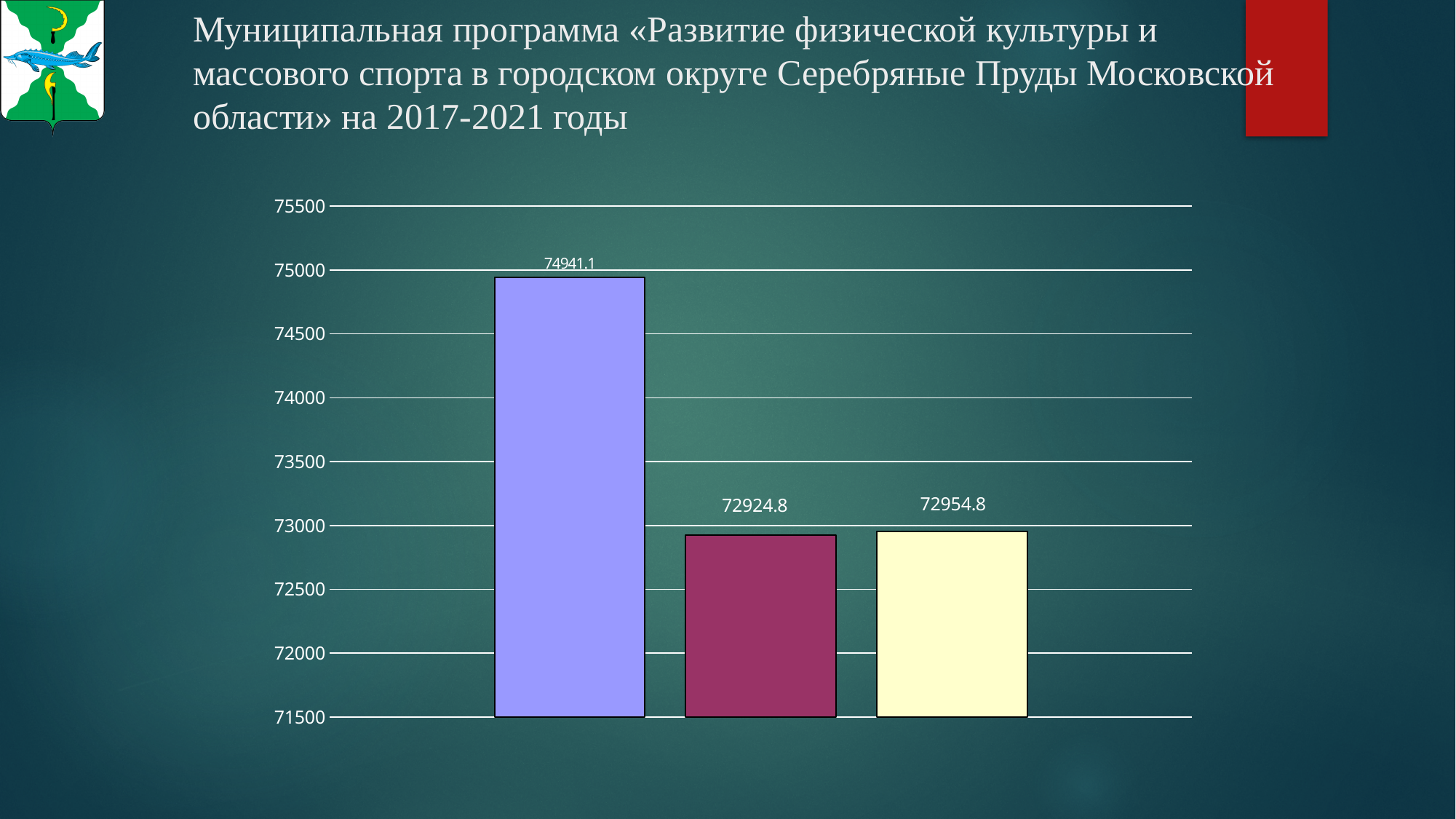
What is the value shown on the rightmost (yellow) bar? 72954.8 What is the value shown on the leftmost (blue) bar? 74941.1 How many bars are plotted in the chart? 3 Is the value of the leftmost bar greater or less than 74500? greater What type of chart is shown on the slide? bar chart Which is larger, the value of the middle bar or the value of the rightmost bar? the rightmost bar (72954.8) What is the highest value labelled on the vertical axis? 75500 What is the value shown on the middle (purple) bar? 72924.8 What is the difference between the rightmost bar and the middle bar? 30 Which bar has the highest value? the leftmost (blue) bar, 74941.1 Which bar has the lowest value? the middle (purple) bar, 72924.8 What is the difference between the leftmost bar and the middle bar? 2016.3